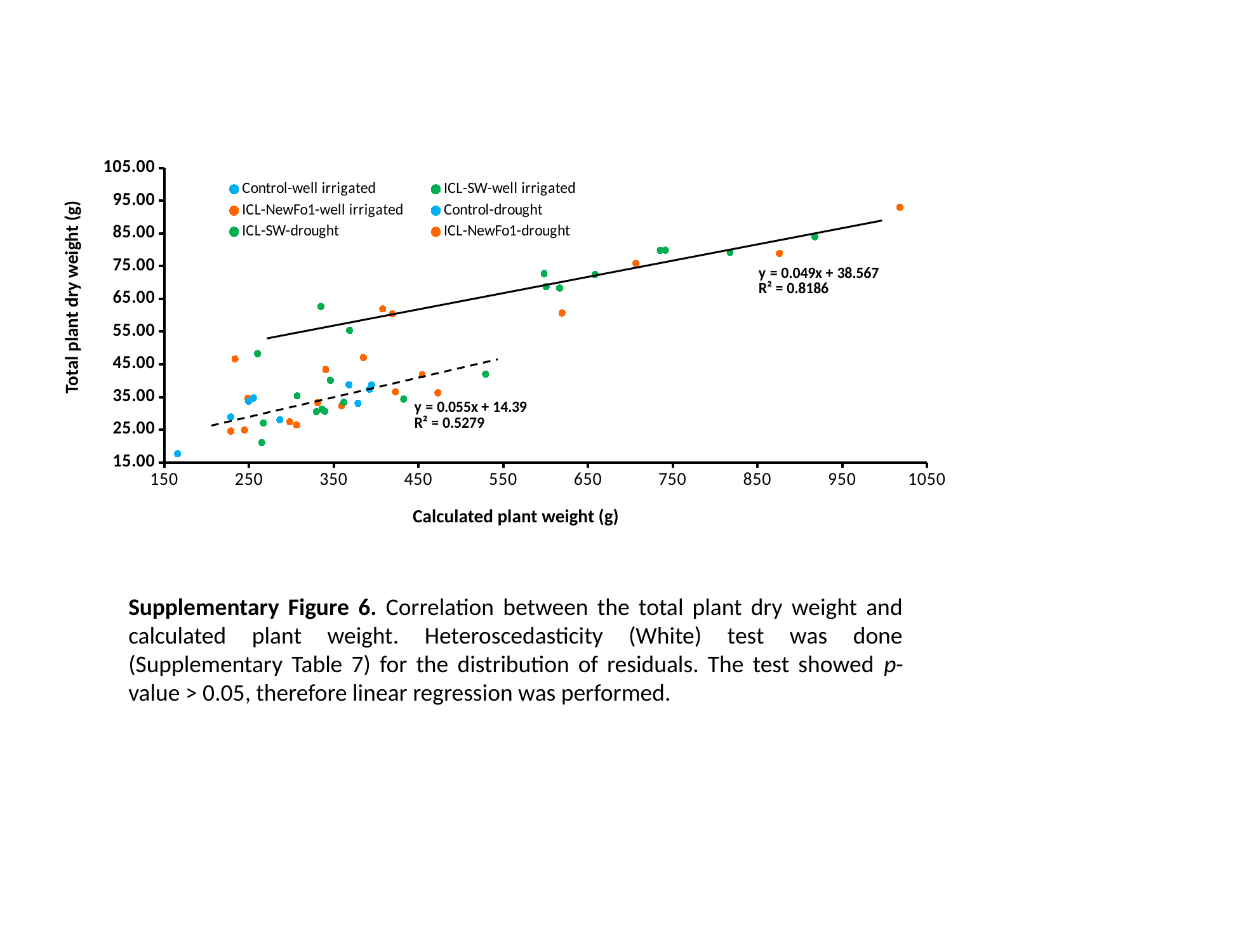
What kind of chart is shown on the slide? scatter chart How many series does the legend list? 6 What is the R² value printed for the dashed trendline? 0.5279 What is the R² value printed for the solid trendline? 0.8186 What is the equation printed next to the dashed trendline? y = 0.055x + 14.39 Do the total plant dry weight values generally rise or fall as calculated plant weight increases along the x axis? rise Is the highest total plant dry weight plotted greater or less than 85.00? greater Is the largest calculated plant weight plotted greater or less than 950? greater Is the lowest total plant dry weight plotted greater or less than 25.00? less